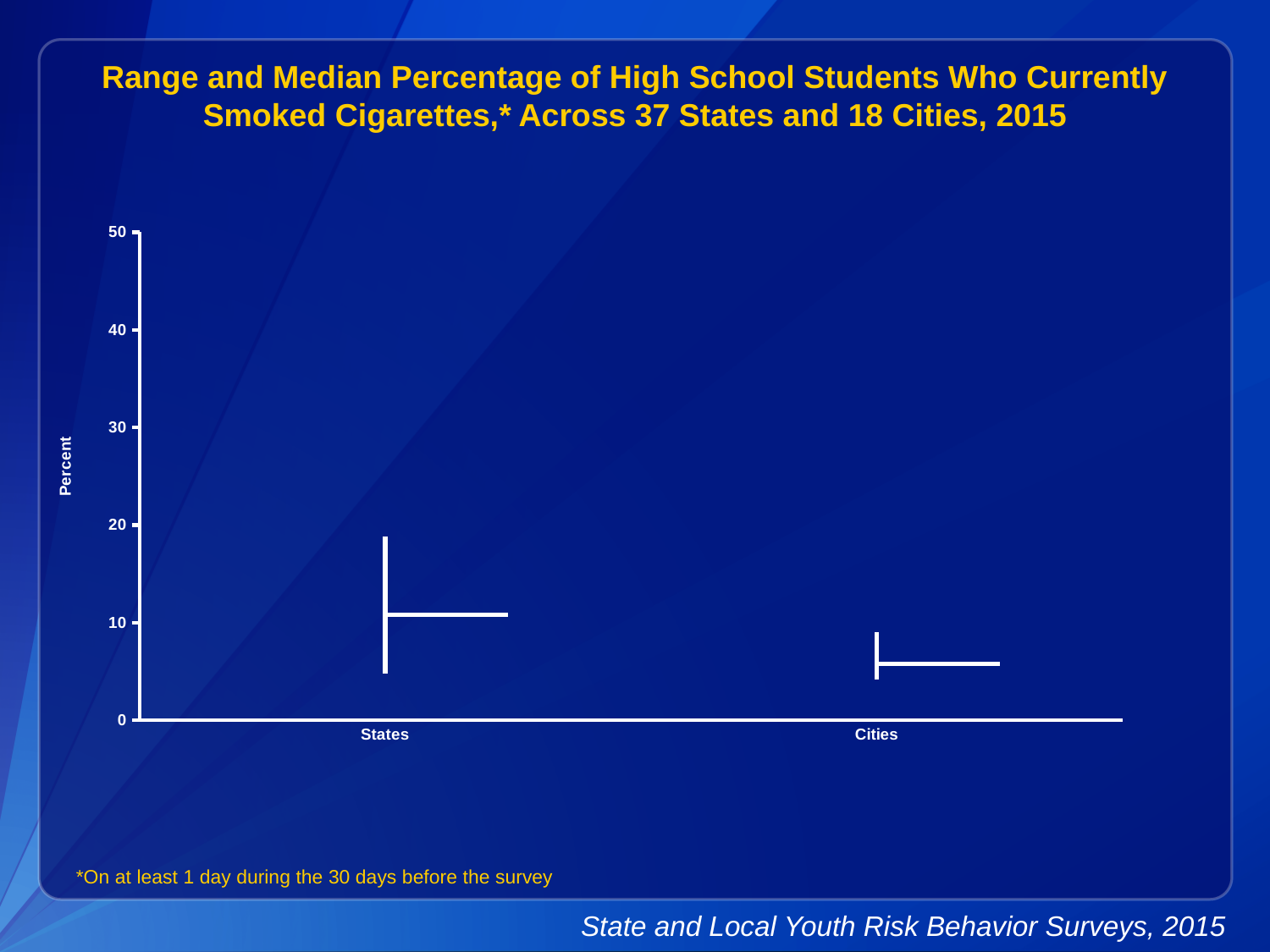
What are the two categories shown on the x axis? States and Cities Which category has the higher median percentage, States or Cities? States Which category has the lower median percentage? Cities Is the median value for Cities greater or less than 10? less Is the highest value in the range for Cities greater or less than 20? less How many categories are shown on the x axis of the chart? 2 Is the highest value in the range for States greater or less than 30? less What is the highest tick value shown on the y axis? 50 Which category shows the wider range of percentages, States or Cities? States What is the label on the y axis of the chart? Percent